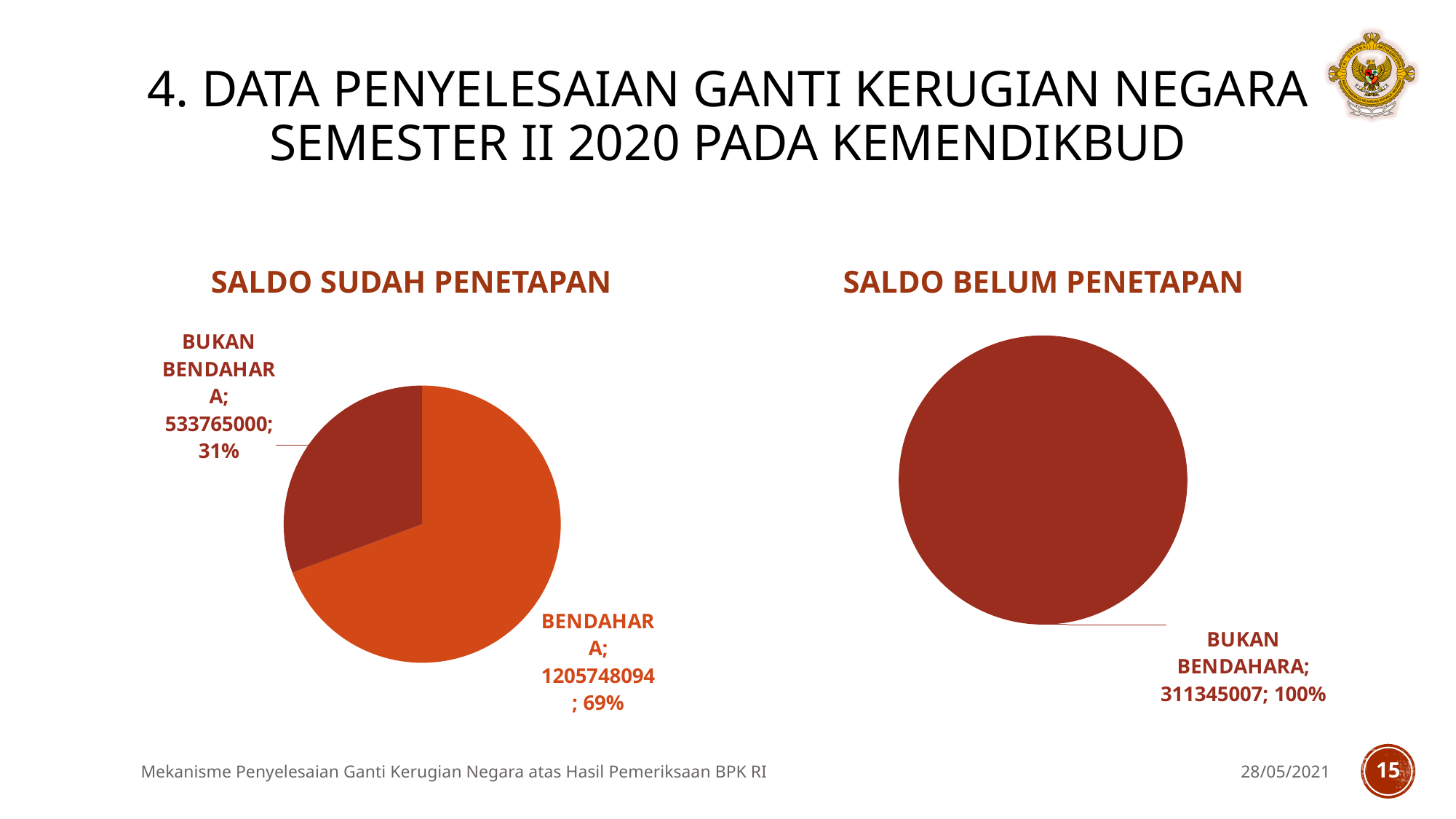
In the 'SALDO SUDAH PENETAPAN' chart, which category has the smallest slice? BUKAN BENDAHARA In the 'SALDO BELUM PENETAPAN' chart, what share of the pie does BUKAN BENDAHARA take? 100% In the 'SALDO SUDAH PENETAPAN' chart, what is the difference between the BENDAHARA and BUKAN BENDAHARA values? 671983094 What type of chart is the 'SALDO SUDAH PENETAPAN' chart? Pie chart In the 'SALDO SUDAH PENETAPAN' chart, which category has the largest slice? BENDAHARA In the 'SALDO SUDAH PENETAPAN' chart, what share of the pie does BENDAHARA take? 69% In the 'SALDO SUDAH PENETAPAN' chart, what is the value for BENDAHARA? 1205748094 In the 'SALDO SUDAH PENETAPAN' chart, what share of the pie does BUKAN BENDAHARA take? 31% In the 'SALDO BELUM PENETAPAN' chart, what is the value for BUKAN BENDAHARA? 311345007 In the 'SALDO SUDAH PENETAPAN' chart, what is the value for BUKAN BENDAHARA? 533765000 In the 'SALDO SUDAH PENETAPAN' chart, how many slices does the pie have? 2 In the 'SALDO BELUM PENETAPAN' chart, how many categories are shown? 1